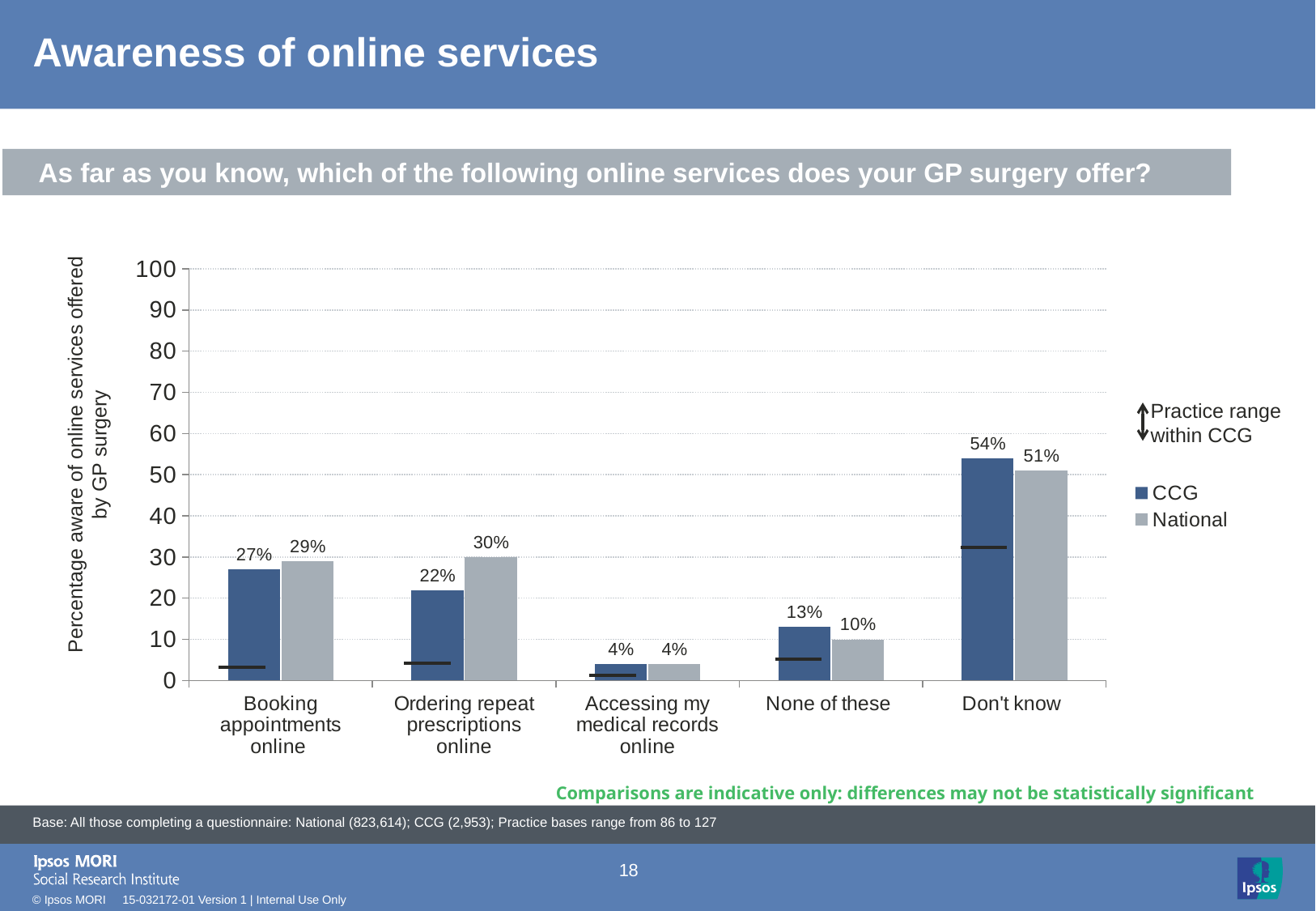
Which category has the highest CCG value? Don't know What is the National value for None of these? 10% What is the label of the y axis? Percentage aware of online services offered by GP surgery What is the CCG value for Don't know? 54% What kind of chart is shown on the slide? Bar chart Which category has the lowest National value? Accessing my medical records online What is the difference between the National and CCG values for Ordering repeat prescriptions online? 8% Which is larger for None of these, the CCG value or the National value? CCG What is the National value for Ordering repeat prescriptions online? 30% What is the CCG value for Booking appointments online? 27% How many data series does the legend list? 2 How many categories are shown on the x axis? 5